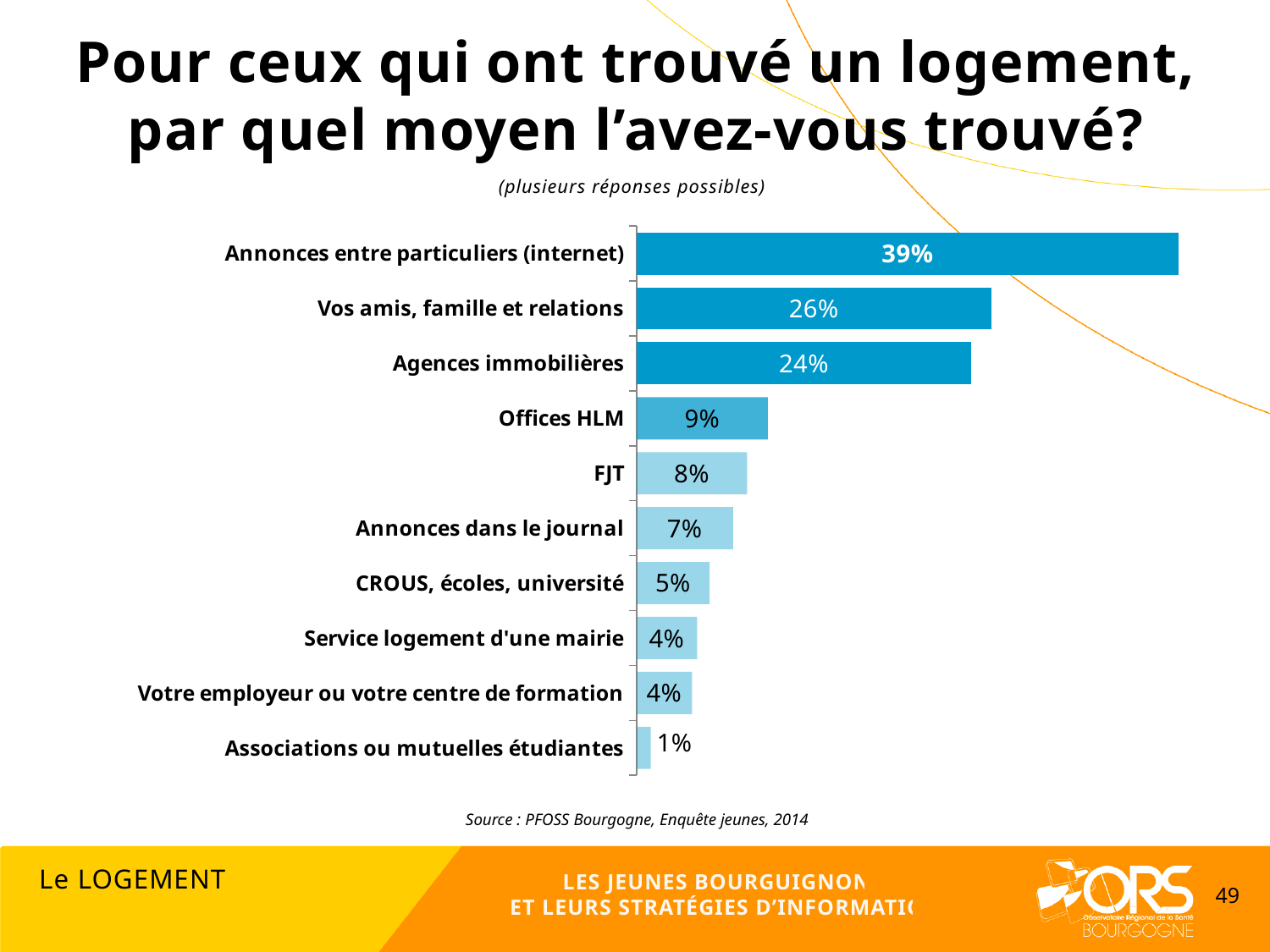
What source is cited below the chart? PFOSS Bourgogne, Enquête jeunes, 2014 What is the difference between 'Annonces entre particuliers (internet)' and 'FJT'? 31% How many categories are shown in the chart? 10 Which category has the highest value? Annonces entre particuliers (internet) What is the value for 'CROUS, écoles, université'? 5% What is the difference between 'Vos amis, famille et relations' and 'Agences immobilières'? 2% What is the value for 'Agences immobilières'? 24% What kind of chart is shown on the slide? Bar chart What percentage found their housing through 'Annonces entre particuliers (internet)'? 39% Which category has the lowest value? Associations ou mutuelles étudiantes What is the value for 'Offices HLM'? 9% Which is larger: 'Offices HLM' or 'Annonces dans le journal'? Offices HLM